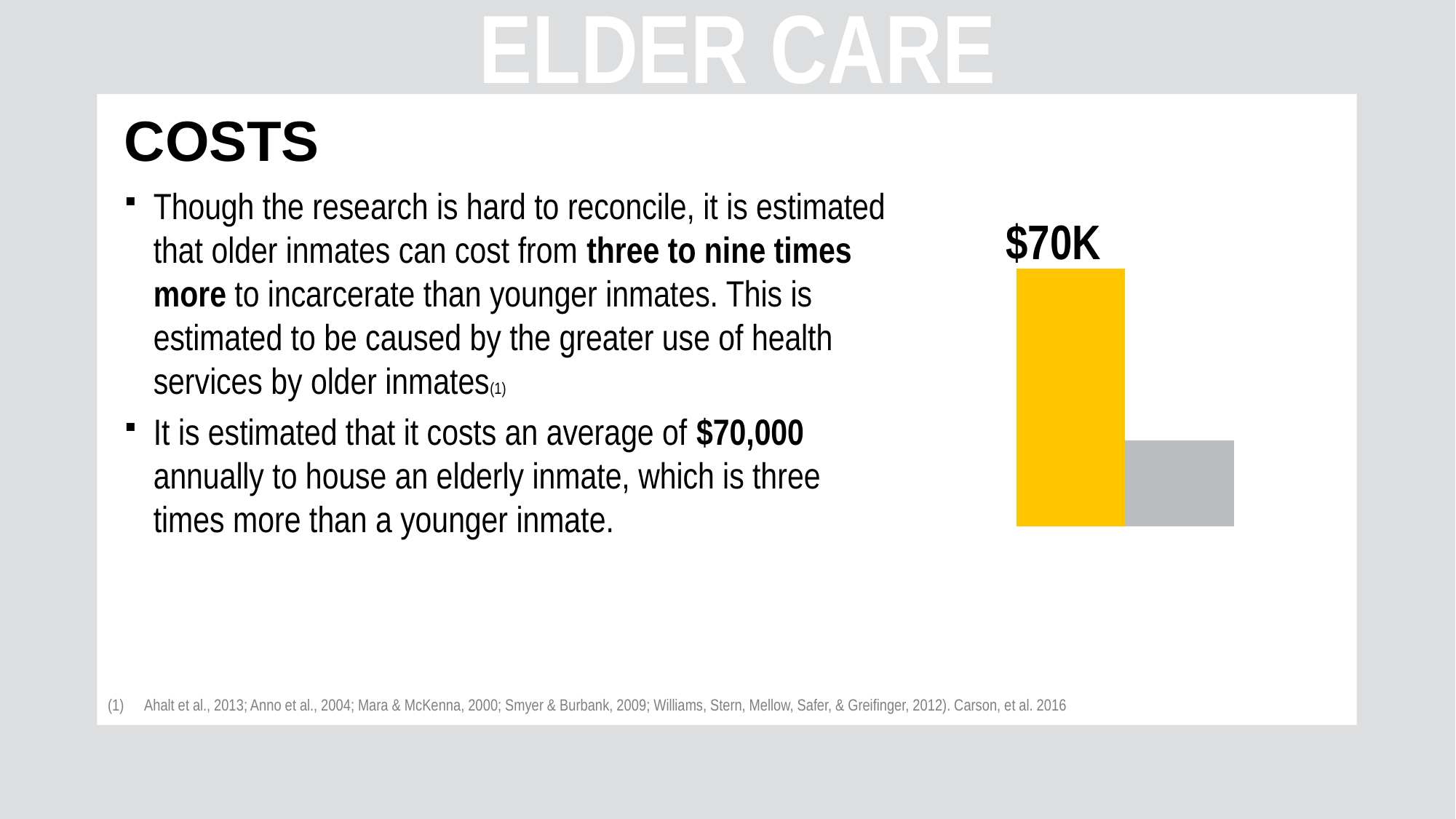
Do the bar heights in the chart rise or fall from left to right? fall What colour is the bar labelled $70K in the chart? yellow What value is labelled on the tall yellow bar in the chart? $70K Which bar in the chart has the highest value? the yellow bar on the left What kind of chart is shown on the right side of the slide? bar chart Which bar in the chart has the lowest value? the gray bar on the right How many bars does the chart on the slide show? 2 Which bar in the chart is taller, the yellow bar on the left or the gray bar on the right? the yellow bar on the left